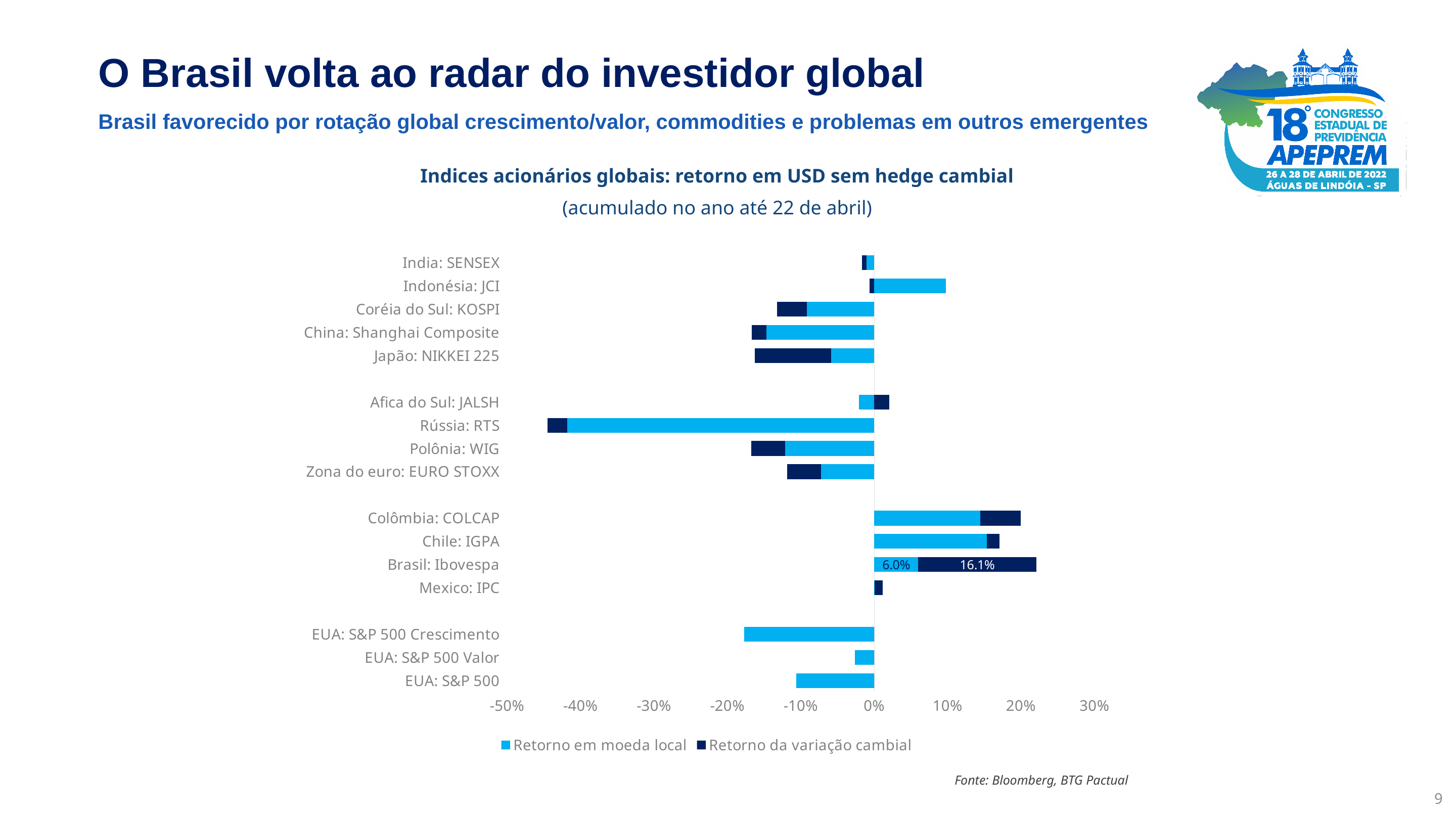
Is the 'Retorno em moeda local' for Rússia: RTS greater or less than -40%? less Is the 'Retorno em moeda local' for EUA: S&P 500 Crescimento greater or less than -10%? less How many series does the legend list? 2 What is the 'Retorno da variação cambial' value for Brasil: Ibovespa? 16.1% Which index has the highest 'Retorno da variação cambial'? Brasil: Ibovespa What is the total return in USD for Brasil: Ibovespa (sum of the two stacked segments)? 22.1% How many indices (categories) are labelled on the chart? 16 What kind of chart is shown on the slide? bar chart What is the 'Retorno em moeda local' value for Brasil: Ibovespa? 6.0% Which index has the lowest 'Retorno em moeda local'? Rússia: RTS Which has the larger 'Retorno em moeda local', Indonésia: JCI or Brasil: Ibovespa? Indonésia: JCI What are the two series named in the legend? Retorno em moeda local; Retorno da variação cambial